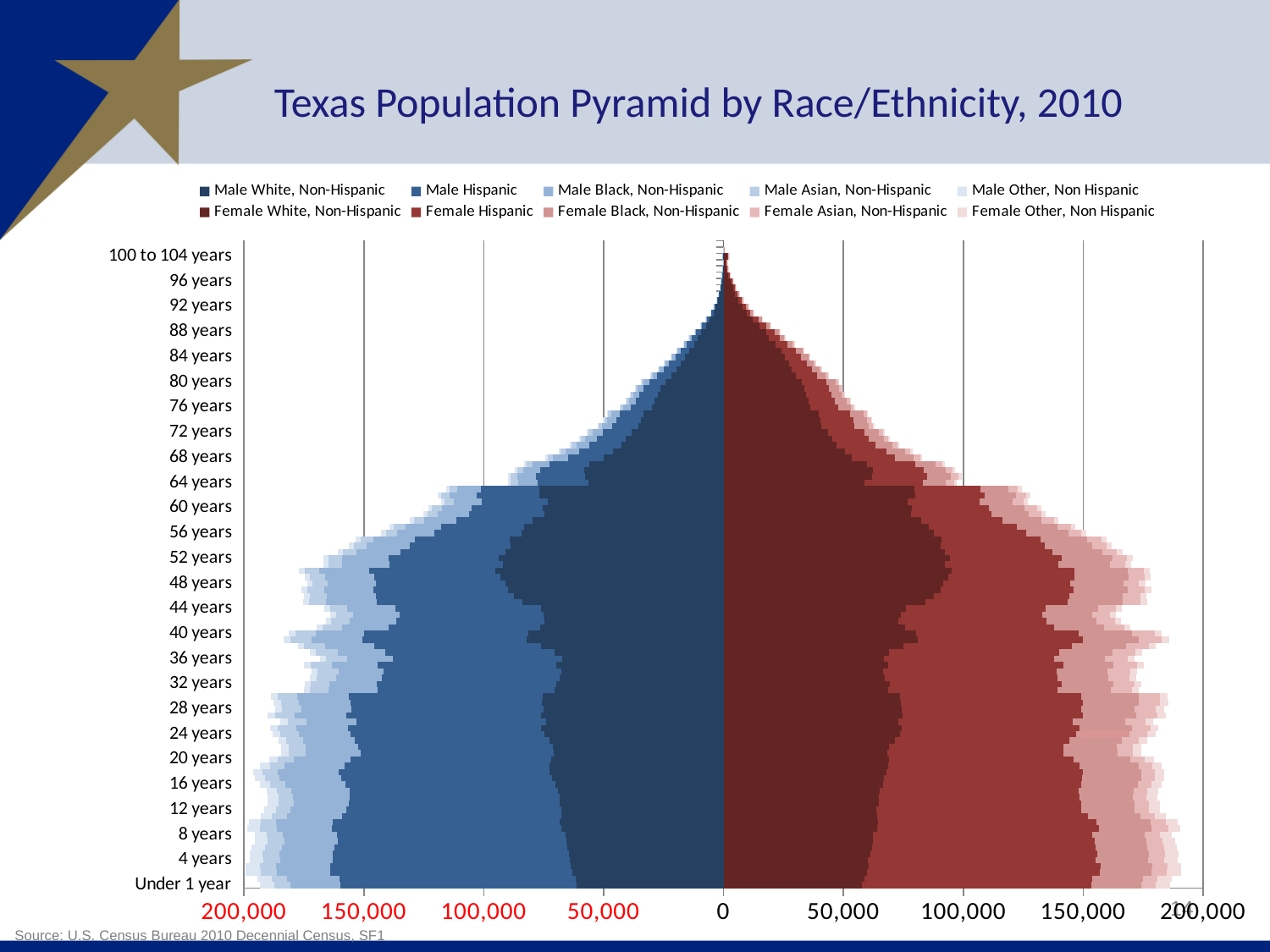
What kind of chart is shown on the slide? Bar chart (population pyramid) What is the title of the chart? Texas Population Pyramid by Race/Ethnicity, 2010 Moving from the youngest age groups at the bottom to the oldest at the top, do the bar lengths generally increase or decrease? Decrease Which has the larger total male population, 40 years or 80 years? 40 years Is the total male value for 80 years greater or less than 50,000? less Which side of the chart shows the male population, left or right? Left Is the total female value for 84 years greater or less than 50,000? less Is the total female value for Under 1 year greater or less than 150,000? greater Which has the larger total female population, 8 years or 92 years? 8 years How many series does the legend list? 10